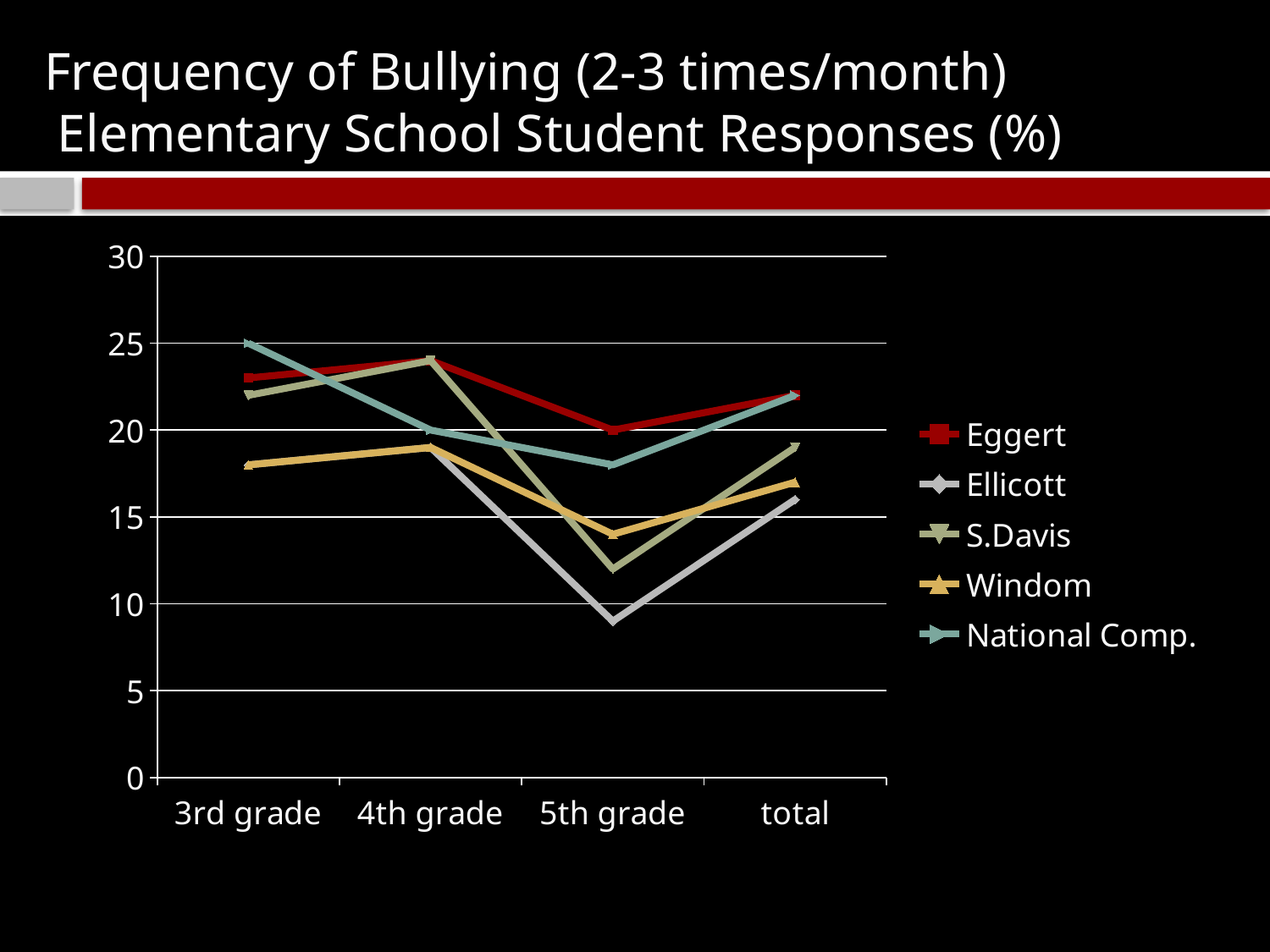
Is the value for S.Davis at 4th grade greater or less than 20? greater Which series has the highest value at 3rd grade? National Comp. How many categories are shown along the x axis? 4 Which series has the highest value at 5th grade? Eggert At 3rd grade, which is larger: Eggert or Windom? Eggert What is the value for Eggert at 5th grade? 20 Does the Ellicott line rise or fall from 3rd grade to 5th grade? fall How many series does the legend list? 5 What kind of chart is shown on the slide? line chart What is the value for National Comp. at 3rd grade? 25 Is the value for Ellicott at 5th grade greater or less than 10? less Which series has the lowest value at 5th grade? Ellicott